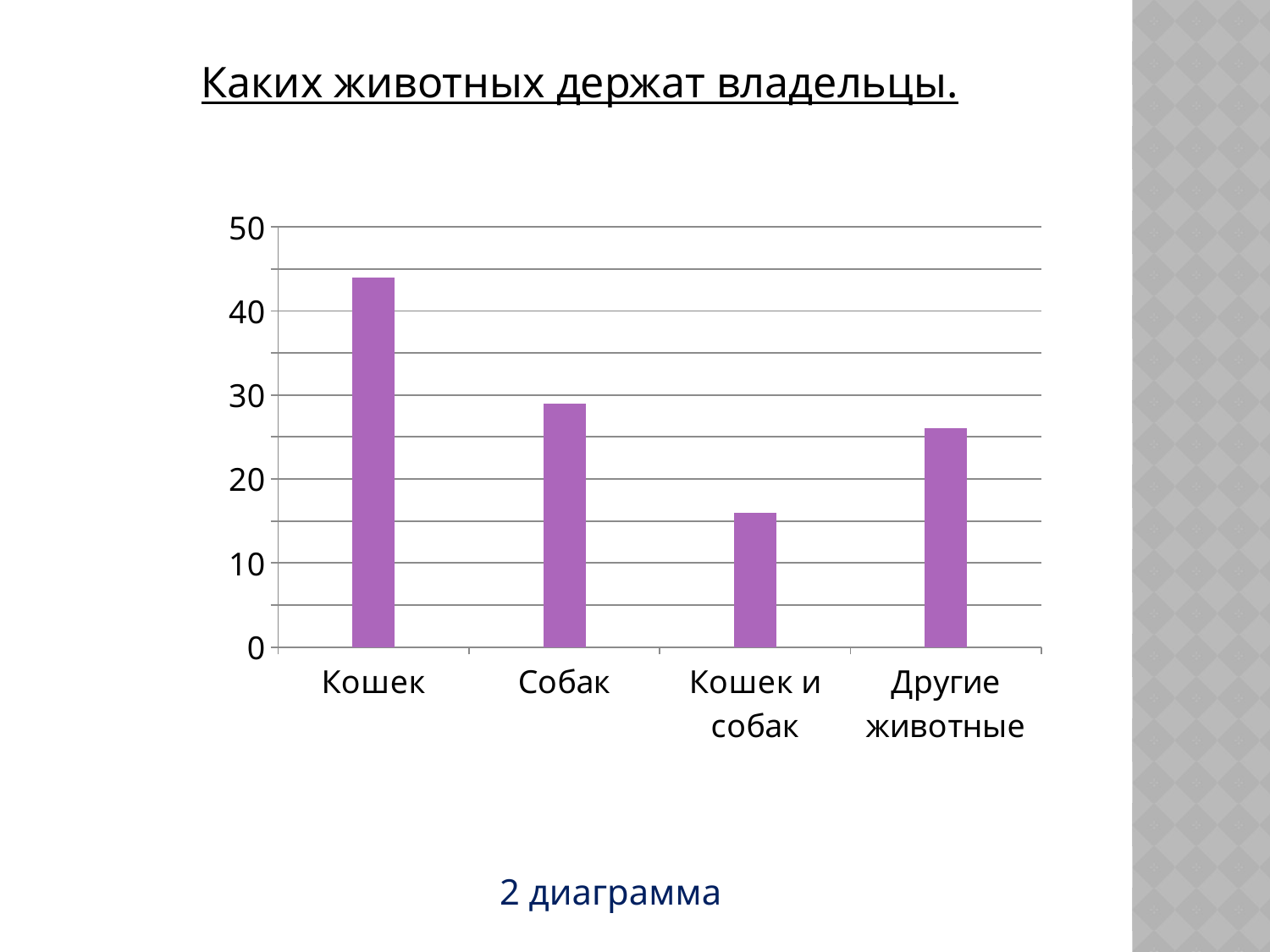
Which is larger, the value for Кошек or the value for Собак? Кошек Which is larger, the value for Собак or the value for Кошек и собак? Собак Is the value for Кошек greater or less than 40? greater Is the value for Другие животные greater or less than 30? less Is the value for Кошек и собак greater or less than 20? less How many categories are shown on the x axis of the chart? 4 Which category has the highest bar? Кошек Which category has the lowest bar? Кошек и собак What is the title of the slide above the chart? Каких животных держат владельцы. What kind of chart is shown on the slide? bar chart